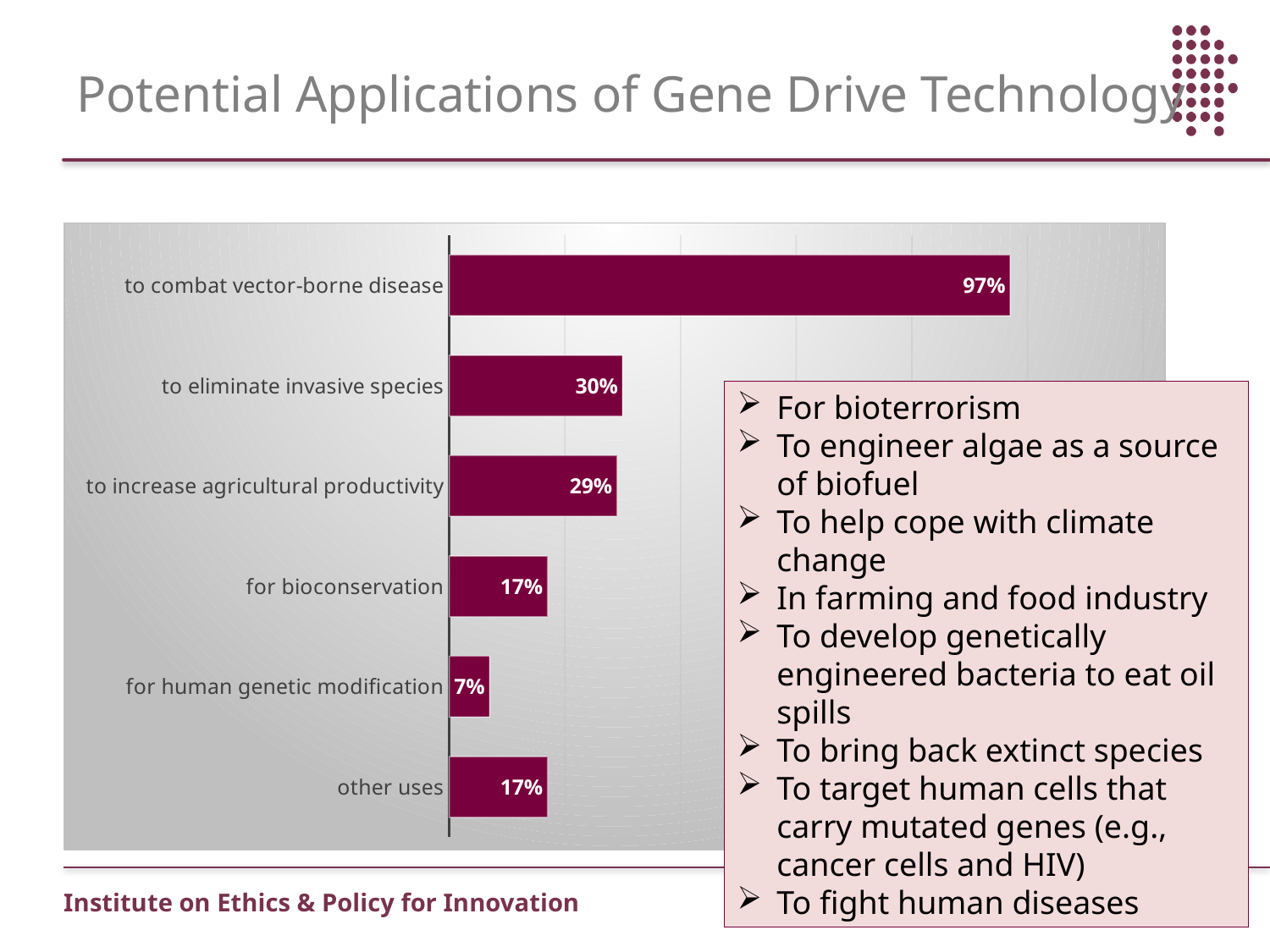
What percentage is shown for "to combat vector-borne disease"? 97% What is the difference between the values for "to combat vector-borne disease" and "to eliminate invasive species"? 67% What percentage is shown for "to eliminate invasive species"? 30% What is the difference between the values for "for bioconservation" and "for human genetic modification"? 10% Which two categories share the same value of 17%? for bioconservation and other uses What kind of chart is shown on the slide? bar chart Which category has the lowest value? for human genetic modification Which is larger, the value for "to eliminate invasive species" or the value for "for bioconservation"? to eliminate invasive species What percentage is shown for "for human genetic modification"? 7% Which category has the highest value? to combat vector-borne disease What percentage is shown for "to increase agricultural productivity"? 29% How many categories are shown in the chart? 6